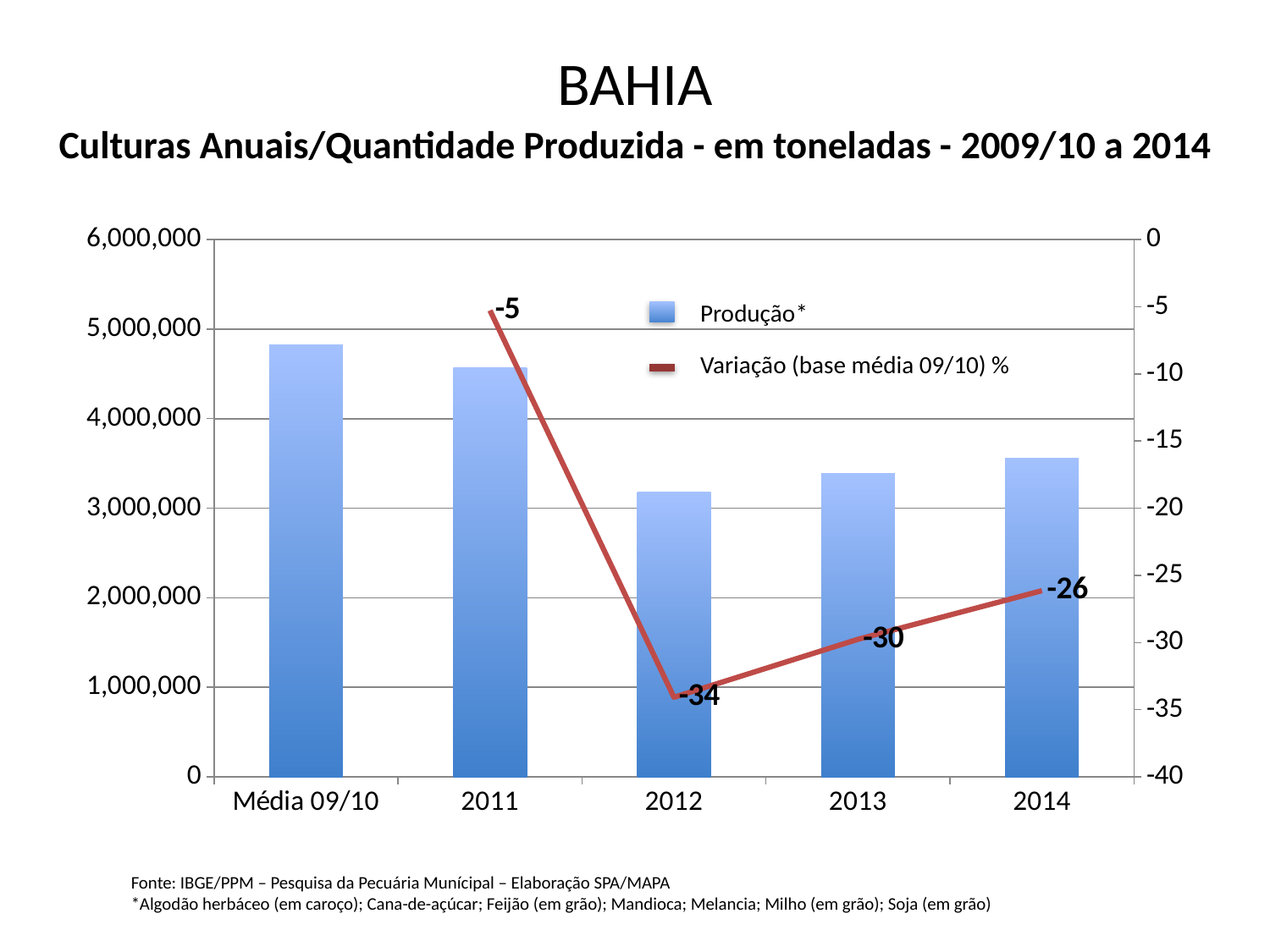
What is the Variação (base média 09/10) % value for 2011? -5 Is the Produção* value for 2011 greater or less than 4,000,000? greater Is the Produção* value for 2012 greater or less than 4,000,000? less By how many percentage points does the Variação value change from 2012 to 2014? 8 How many series does the legend list? 2 How many categories are shown on the x axis? 5 Which category has the highest Produção* bar? Média 09/10 What is the Variação (base média 09/10) % value for 2012? -34 Which year has the lowest Produção* bar? 2012 Which has a larger Produção* value, 2011 or 2012? 2011 What is the Variação (base média 09/10) % value for 2014? -26 What is the Variação (base média 09/10) % value for 2013? -30